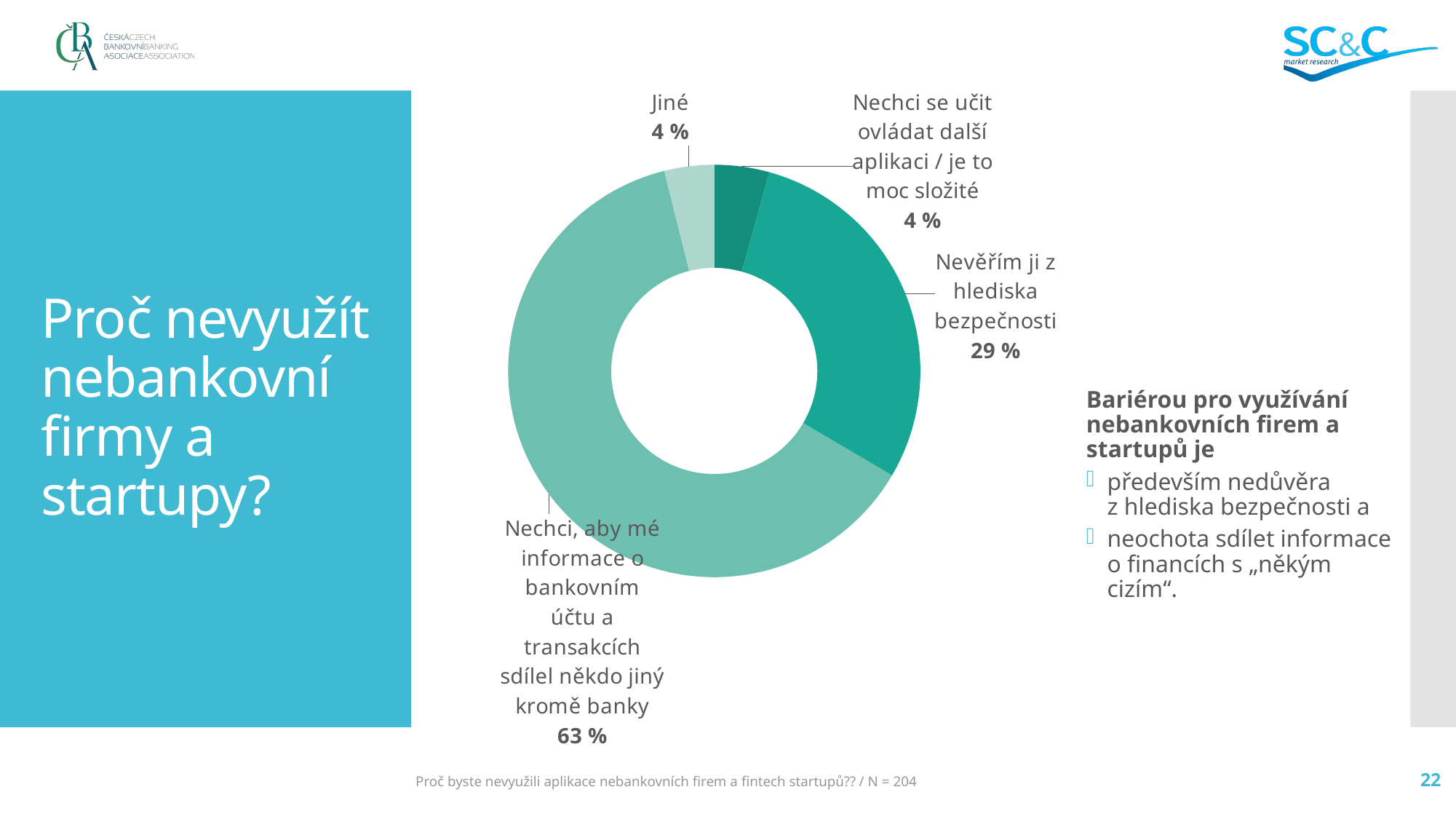
What share of respondents chose "Nechci se učit ovládat další aplikaci / je to moc složité"? 4 % How many categories (slices) does the chart show? 4 Which category has the largest share in the chart? Nechci, aby mé informace o bankovním účtu a transakcích sdílel někdo jiný kromě banky What share of respondents chose "Nevěřím ji z hlediska bezpečnosti"? 29 % What share of respondents chose "Jiné"? 4 % What is the title of the slide? Proč nevyužít nebankovní firmy a startupy? What is the sample size (N) stated in the footnote below the chart? N = 204 What share of respondents chose "Nechci, aby mé informace o bankovním účtu a transakcích sdílel někdo jiný kromě banky"? 63 % What is the combined share of "Jiné" and "Nechci se učit ovládat další aplikaci / je to moc složité"? 8 % Which is larger: the share for "Nevěřím ji z hlediska bezpečnosti" or the share for "Jiné"? Nevěřím ji z hlediska bezpečnosti What is the difference in percentage points between the largest slice (63 %) and "Nevěřím ji z hlediska bezpečnosti" (29 %)? 34 percentage points What kind of chart is shown on the slide? Donut (pie) chart